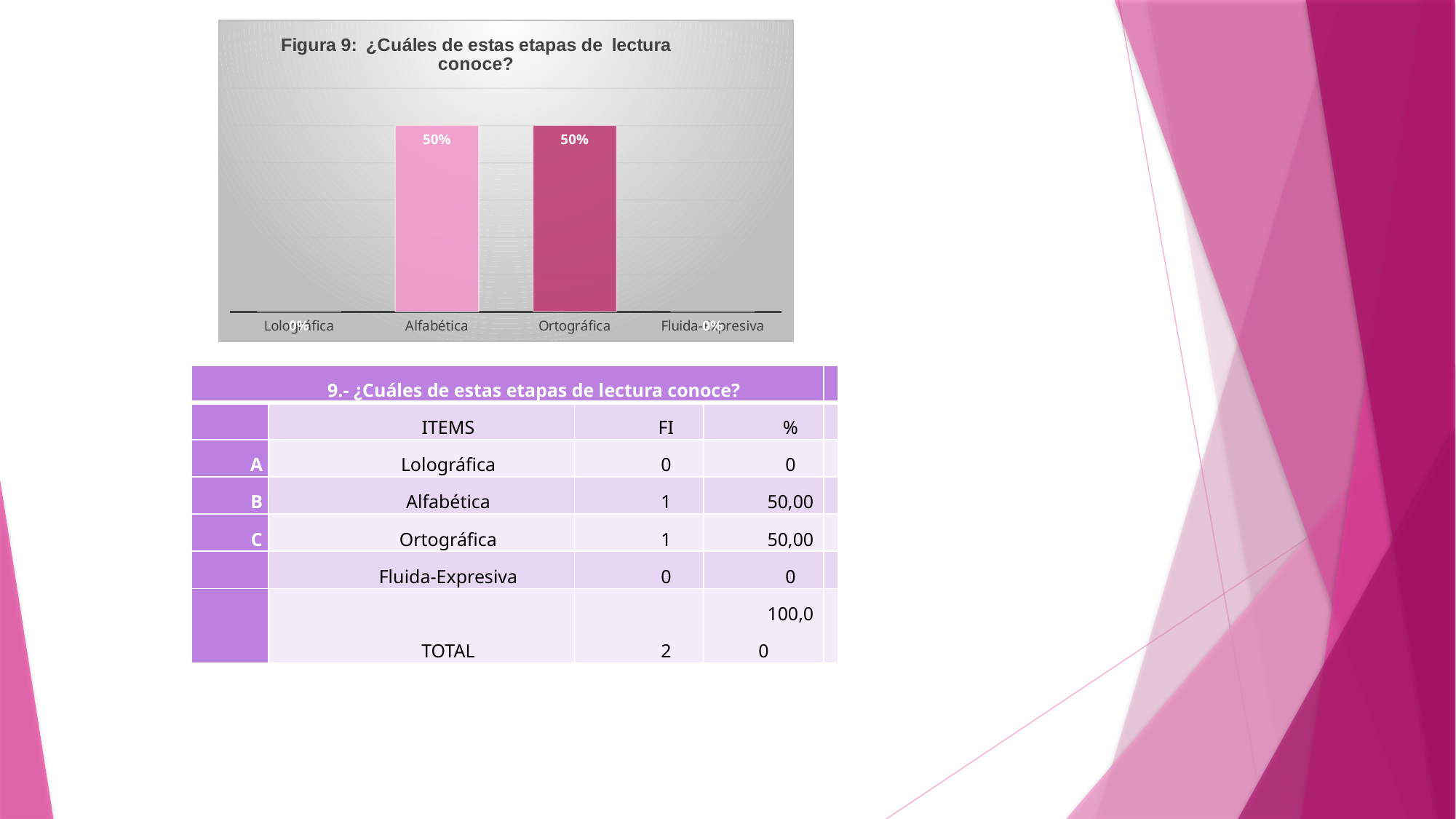
What is the value for Fluida-Expresiva in the chart? 0% What is the difference between the values for Alfabética and Lolográfica? 50% Which is larger, the value for Alfabética or the value for Fluida-Expresiva? Alfabética What is the value for Lolográfica in the chart? 0% What kind of chart is shown on the slide? Bar chart Which categories in the chart have a value of 0%? Lolográfica and Fluida-Expresiva What is the title of the chart? Figura 9: ¿Cuáles de estas etapas de lectura conoce? What is the value for Ortográfica in the chart? 50% What is the value for Alfabética in the chart? 50% How many categories are shown on the x axis of the chart? 4 Which is larger, the value for Lolográfica or the value for Ortográfica? Ortográfica What is the difference between the values for Ortográfica and Fluida-Expresiva? 50%